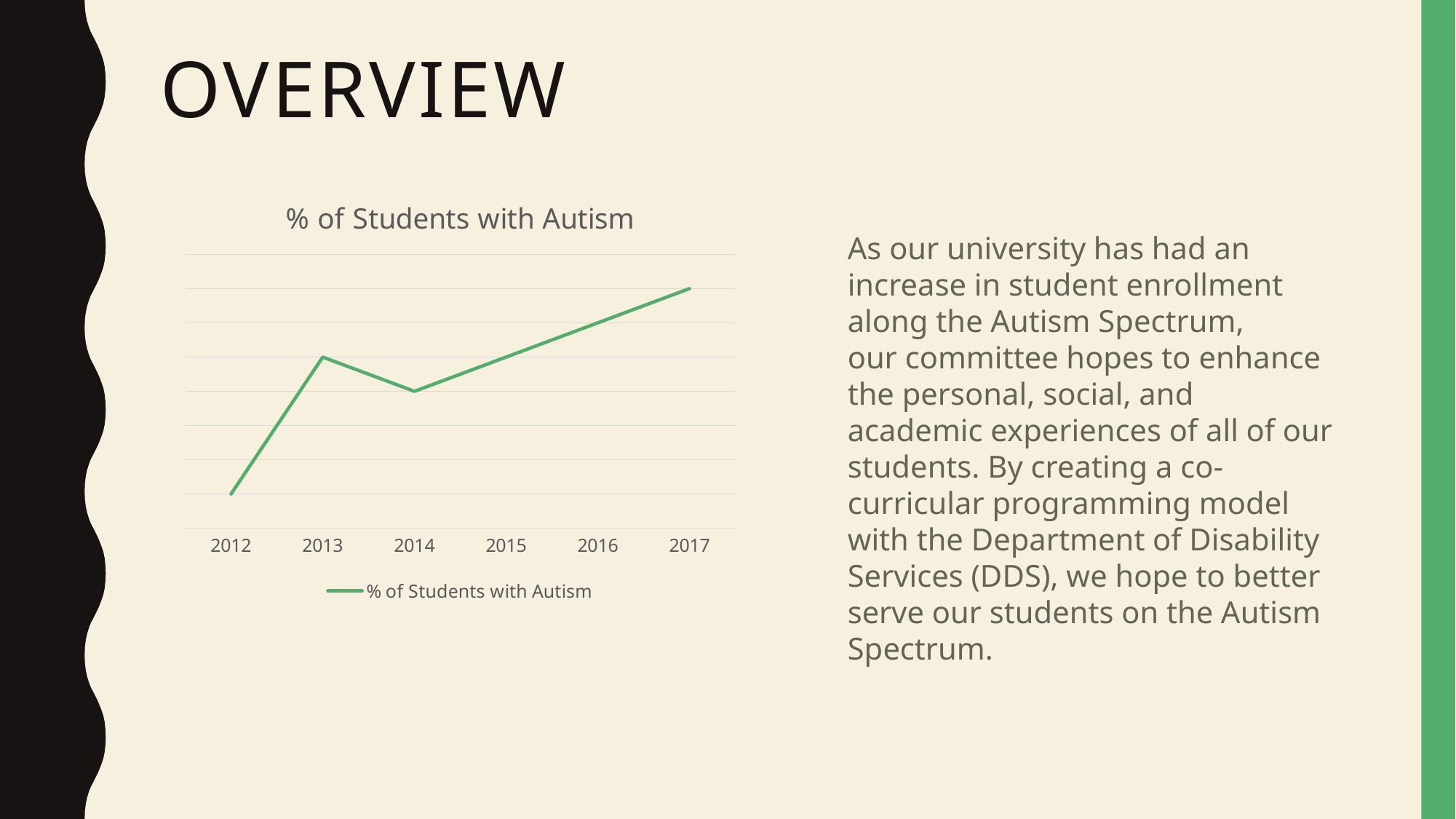
Which year has the larger value, 2013 or 2014? 2013 How many series does the chart's legend list? 1 How many years are plotted on the x axis of the chart? 6 Which year has the highest value in the chart? 2017 What kind of chart is shown on the slide? line chart Does the value rise or fall between 2013 and 2014? fall What colour is the line in the chart? green Which year has the larger value, 2013 or 2016? 2016 Which year has the lowest value in the chart? 2012 Overall, do the values rise or fall from 2012 to 2017? rise Which year has the larger value, 2012 or 2014? 2014 What is the title of the chart? % of Students with Autism